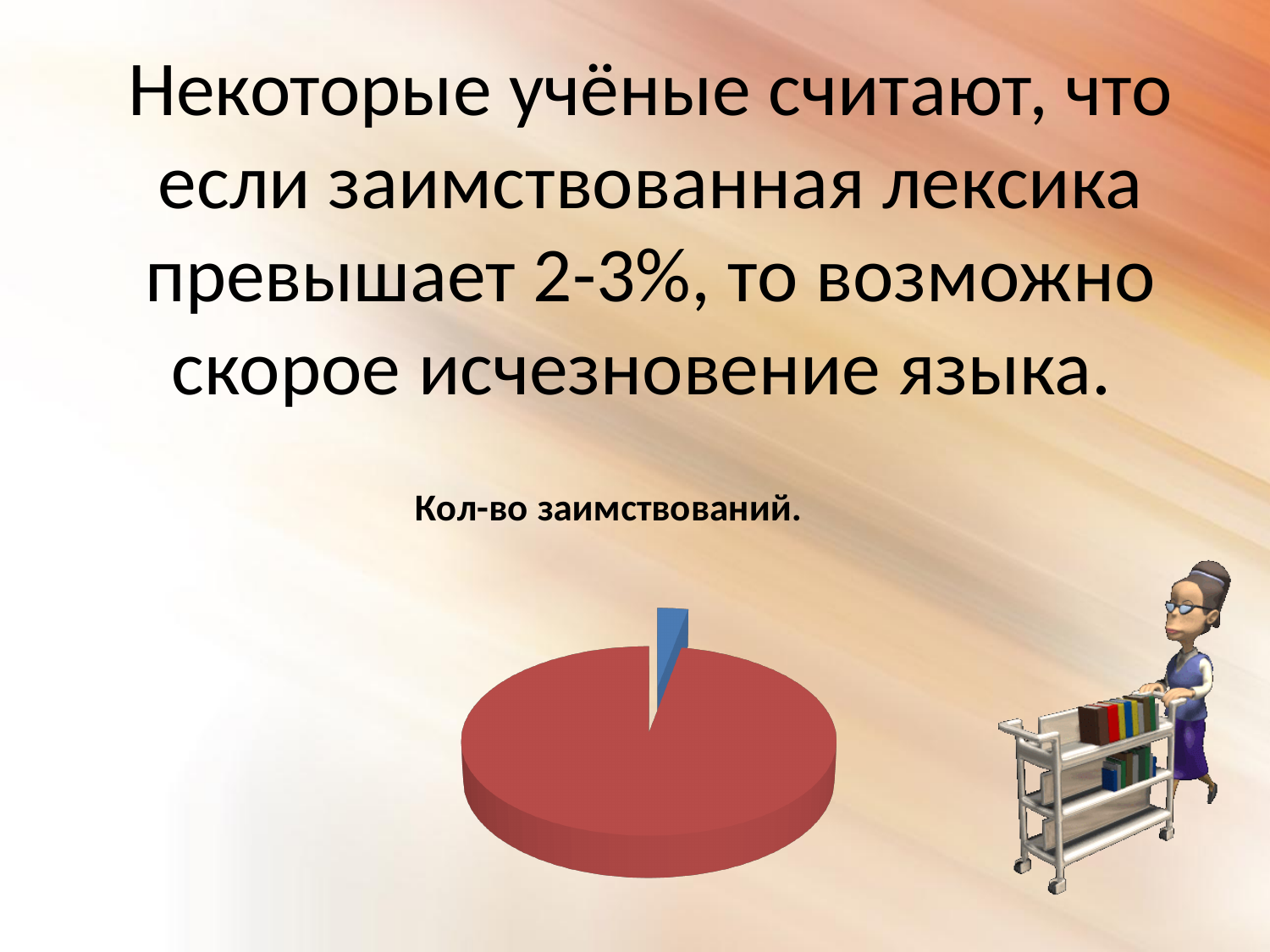
Is the red slice of the pie chart larger or smaller than the blue slice? larger What kind of chart is shown on the slide? pie chart Does the pie chart show a legend? no Which slice of the pie chart is the largest, the red one or the blue one? the red one What is the title of the chart on the slide? Кол-во заимствований. How many slices does the pie chart have? 2 Which slice of the pie chart is the smallest, the red one or the blue one? the blue one